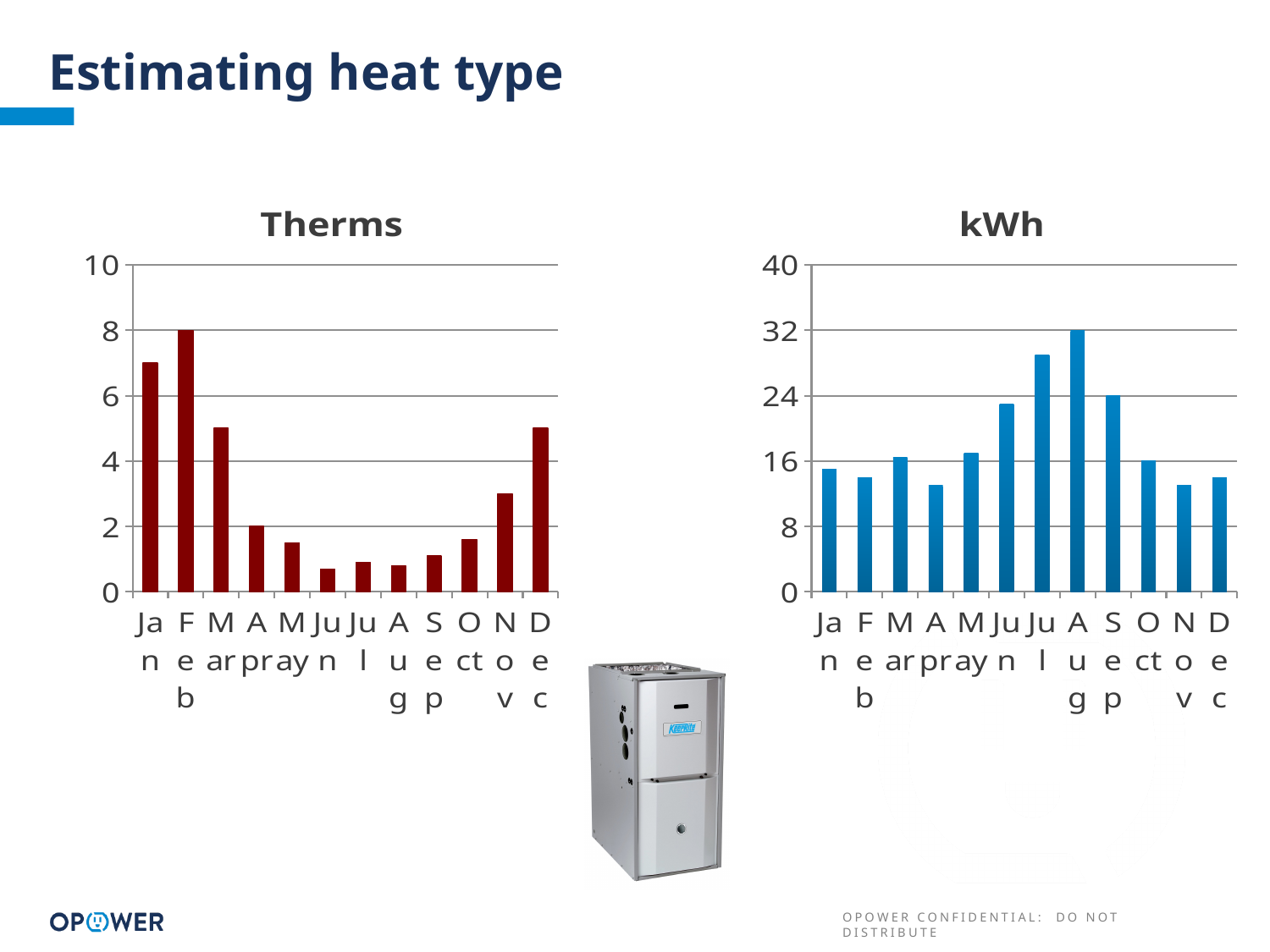
In the kWh chart, do the values rise or fall from Apr to Aug? rise In the Therms chart, which month has the highest value? Feb In the kWh chart, what is the value for Aug? 32 In the kWh chart, is the value for Apr greater or less than 16? less In the kWh chart, what is the value for Sep? 24 How many months are shown on the x axis of the kWh chart? 12 In the Therms chart, is the value for Jan greater or less than 6? greater What kind of chart is the Therms chart? bar chart In the Therms chart, which is larger, the value for Mar or the value for Nov? Mar In the Therms chart, what is the value for Feb? 8 What is the title of the chart on the right side of the slide? kWh In the kWh chart, which month has the highest value? Aug